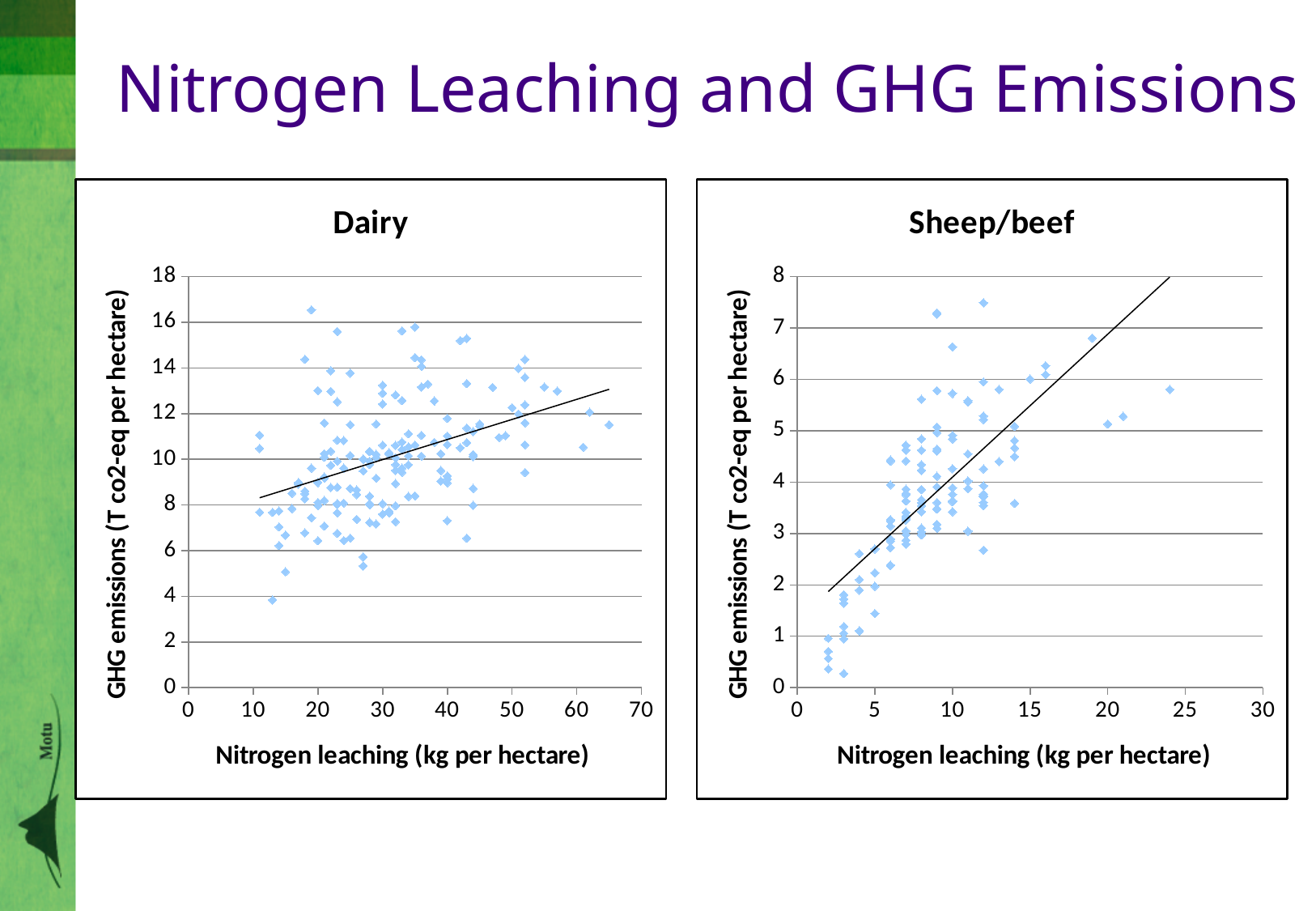
In the Sheep/beef chart, does the fitted trend line rise or fall as nitrogen leaching increases? rise In the Dairy chart, is the highest plotted GHG emissions value greater or less than 16? greater What is the maximum value shown on the y axis of the Dairy chart? 18 What kind of chart is the Dairy chart? scatter chart What kind of chart is the Sheep/beef chart? scatter chart In the Sheep/beef chart, is the lowest plotted GHG emissions value greater or less than 1? less What is the maximum value shown on the x axis of the Sheep/beef chart? 30 In the Dairy chart, do GHG emissions tend to rise or fall as nitrogen leaching increases along the x axis? rise In the Sheep/beef chart, is the highest plotted GHG emissions value greater or less than 7? greater Which chart has the higher maximum value on its y axis, Dairy or Sheep/beef? Dairy How many charts are shown on the slide? 2